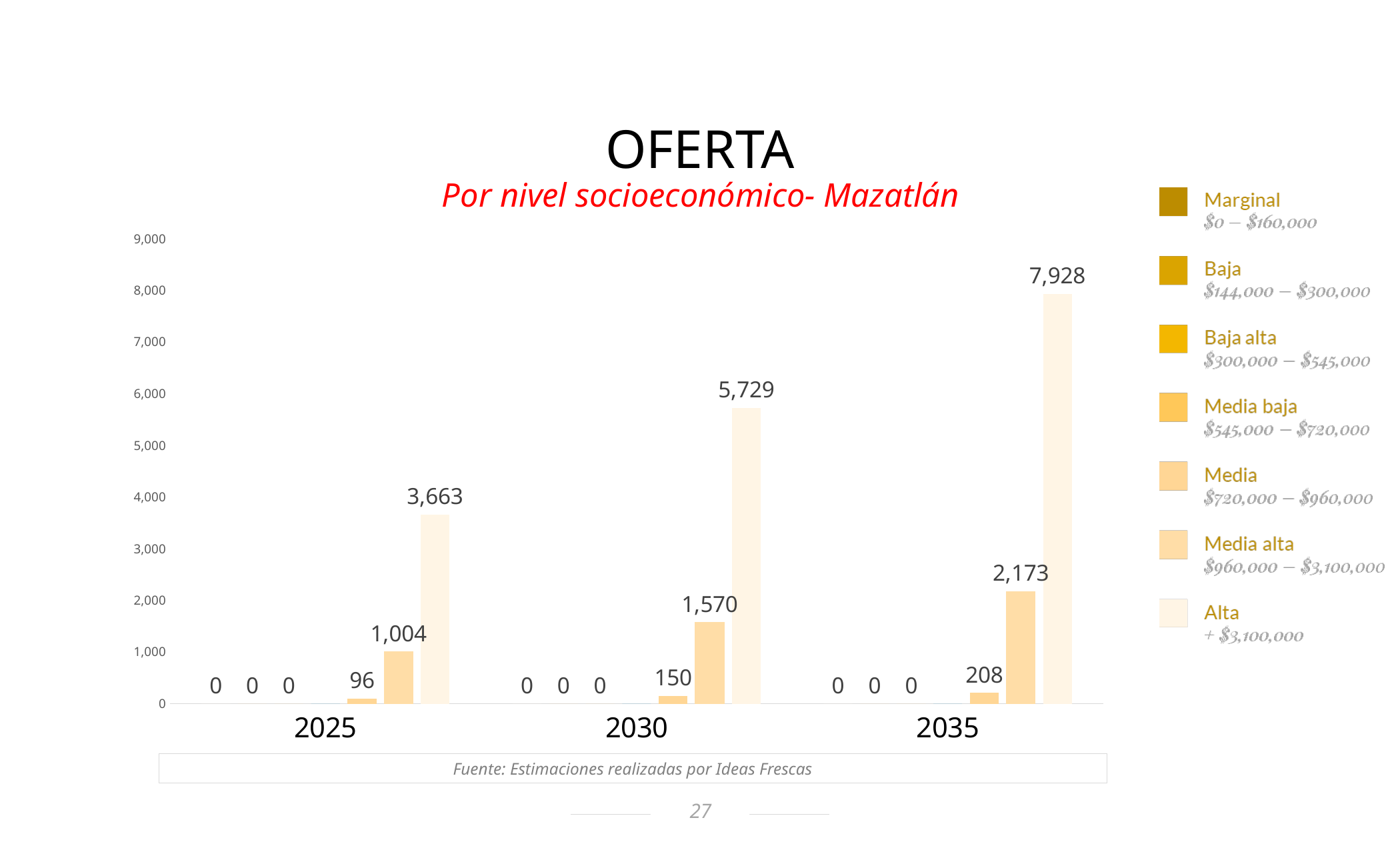
Which is larger: the 2,173 bar in 2035 or the 1,570 bar in 2030? 2,173 in 2035 What is the value of the tallest bar for 2025? 3,663 What is the price range shown in the legend for the 'Alta' level? + $3,100,000 What type of chart is shown on the slide? bar chart Do the tallest bar values rise or fall from 2025 to 2035? rise Which year has the highest single bar value? 2035 What is the smallest non-zero value shown for 2030? 150 How many year categories are shown on the x axis? 3 What is the value of the tallest bar for 2030? 5,729 What is the difference between the tallest bar in 2035 (7,928) and the tallest bar in 2030 (5,729)? 2,199 What is the value of the tallest bar for 2035? 7,928 How many series does the legend list? 7